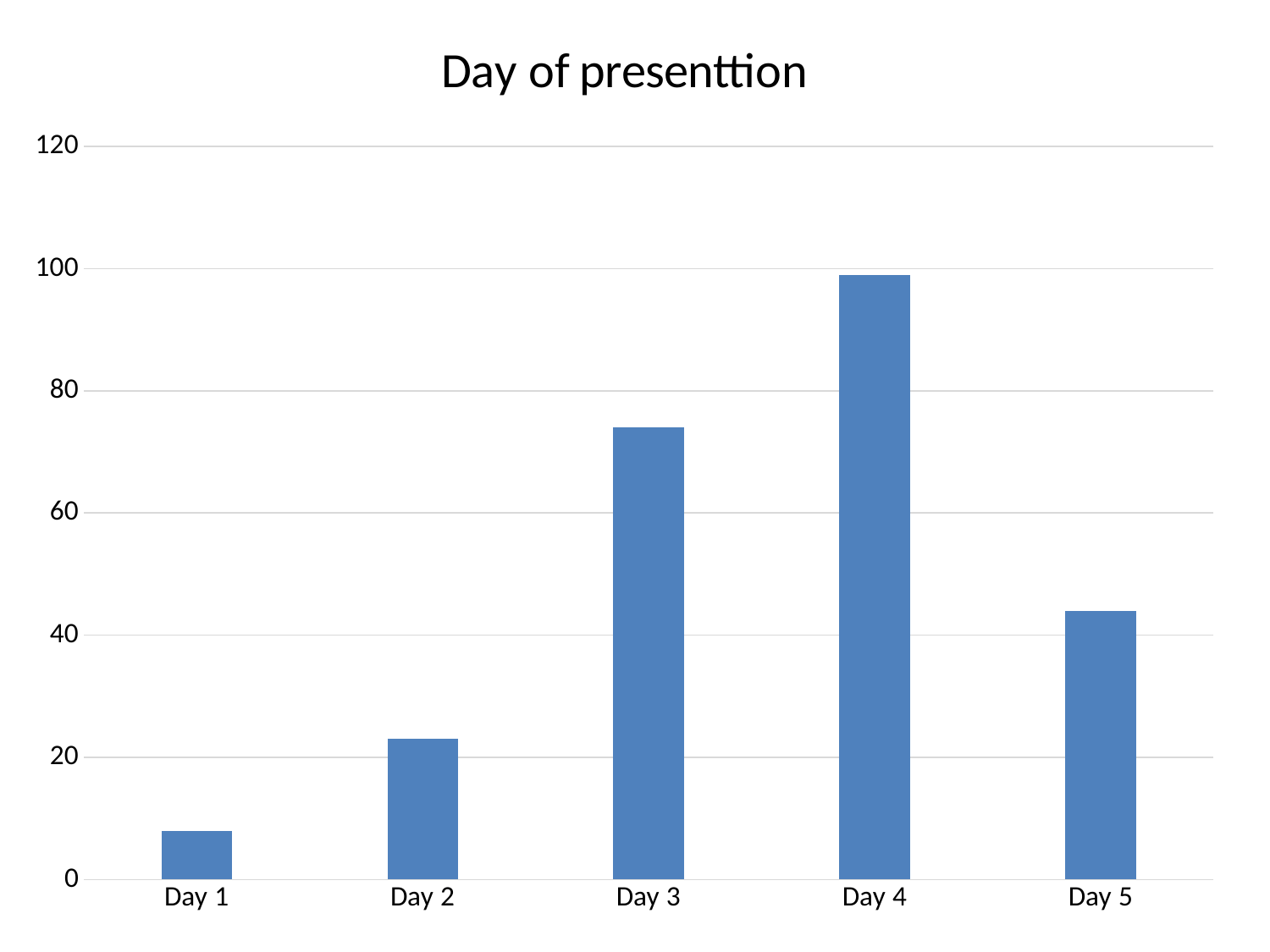
Which day has the highest bar? Day 4 Is the value for Day 2 greater or less than 40? less What kind of chart is shown on the slide? bar chart Is the value for Day 4 greater or less than 80? greater How many categories are plotted on the x axis? 5 Is the value for Day 5 greater or less than 60? less What is the title of the chart? Day of presenttion Which is larger, the value for Day 3 or the value for Day 5? Day 3 Which day has the lowest bar? Day 1 Do the values rise or fall from Day 1 to Day 4? rise